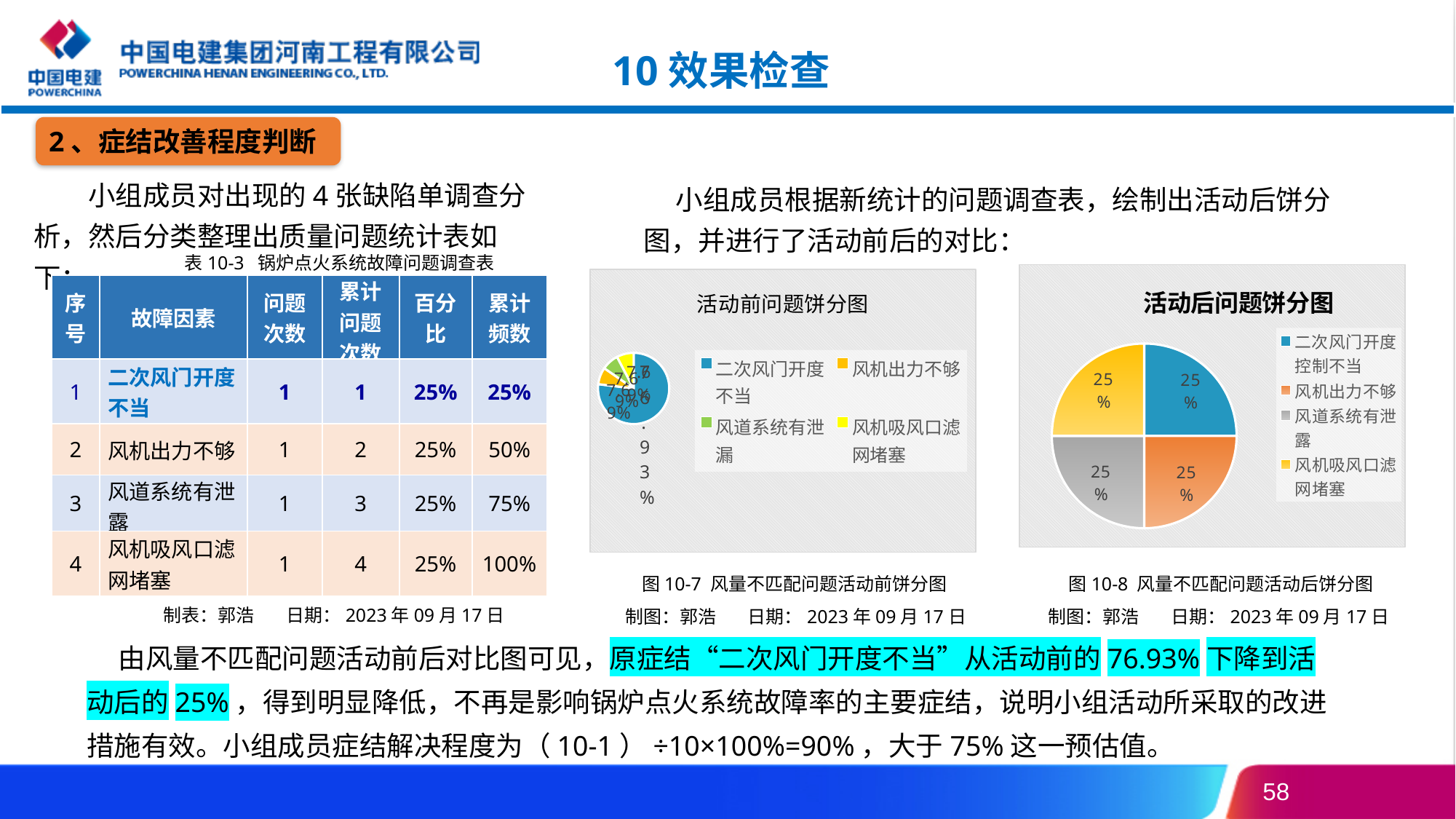
In the 活动前问题饼分图 chart, is the share for 二次风门开度不当 greater or less than 50%? greater In the 活动后问题饼分图 chart, what is the share for 风道系统有泄露? 25% In the 活动前问题饼分图 chart, which category has the largest share? 二次风门开度不当 What kind of chart is the 活动后问题饼分图? Pie chart In the 活动后问题饼分图 chart, what is the share for 二次风门开度控制不当? 25% What is the title of the pie chart on the right side of the slide? 活动后问题饼分图 In the 活动后问题饼分图 chart, what is the share for 风机吸风口滤网堵塞? 25% What kind of chart is the 活动前问题饼分图? Pie chart How many entries does the legend of the 活动前问题饼分图 chart list? 4 In the 活动后问题饼分图 chart, what colour is the slice for 风道系统有泄露? Gray In the 活动后问题饼分图 chart, what is the share for 风机出力不够? 25% How many slices does the 活动后问题饼分图 chart have? 4